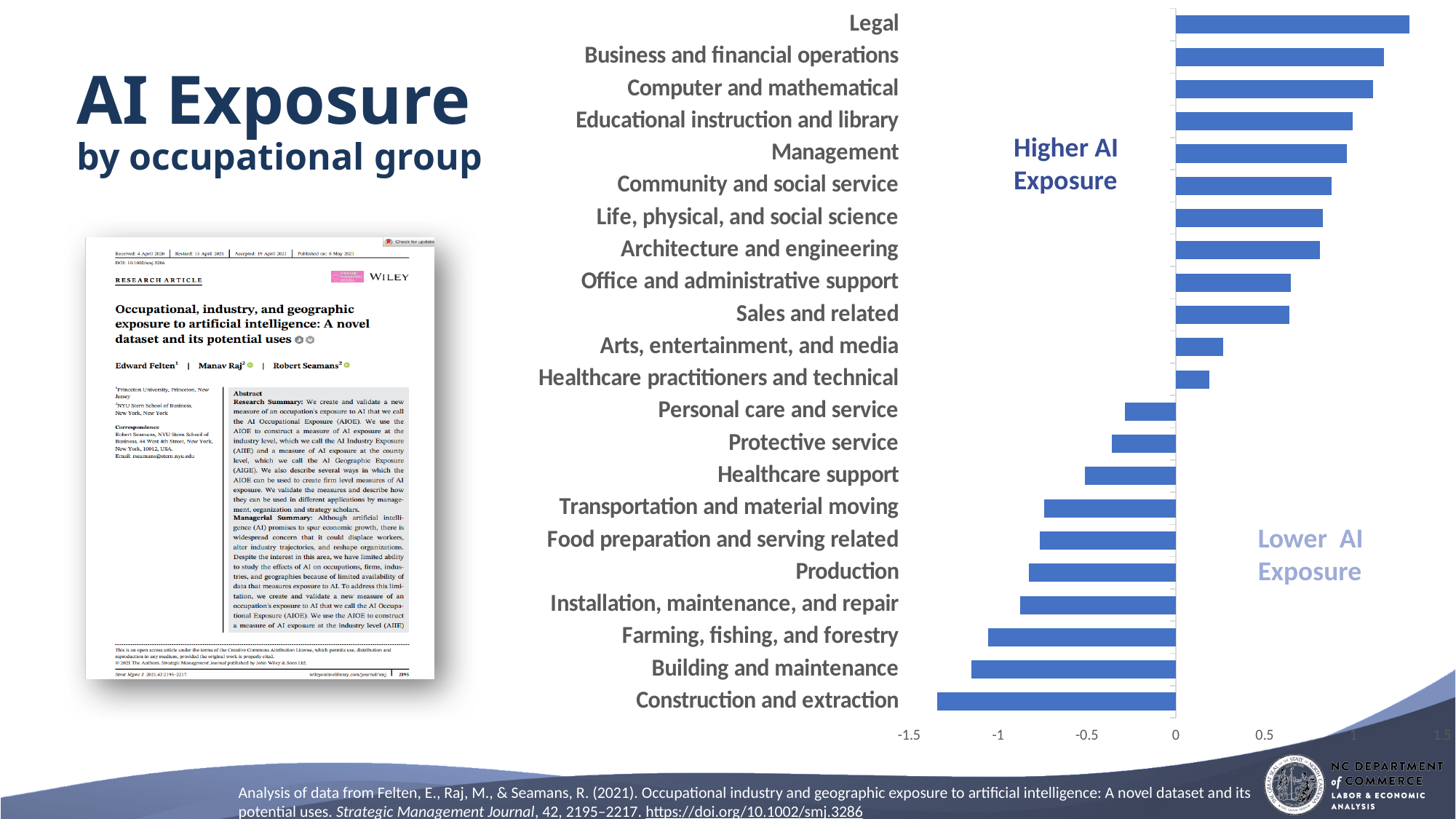
Which occupational group has the lowest AI exposure in the chart? Construction and extraction Is the value for Production greater or less than -1? greater Is the value for Construction and extraction greater or less than -1? less How many occupational groups are plotted in the chart? 22 What is the title of the chart on the slide? AI Exposure by occupational group Which occupational group has the highest AI exposure in the chart? Legal Is the value for Legal greater or less than 1? greater How many occupational groups have a negative AI exposure value in the chart? 10 What kind of chart is shown on the slide? bar chart Which has the larger value, Sales and related or Arts, entertainment, and media? Sales and related